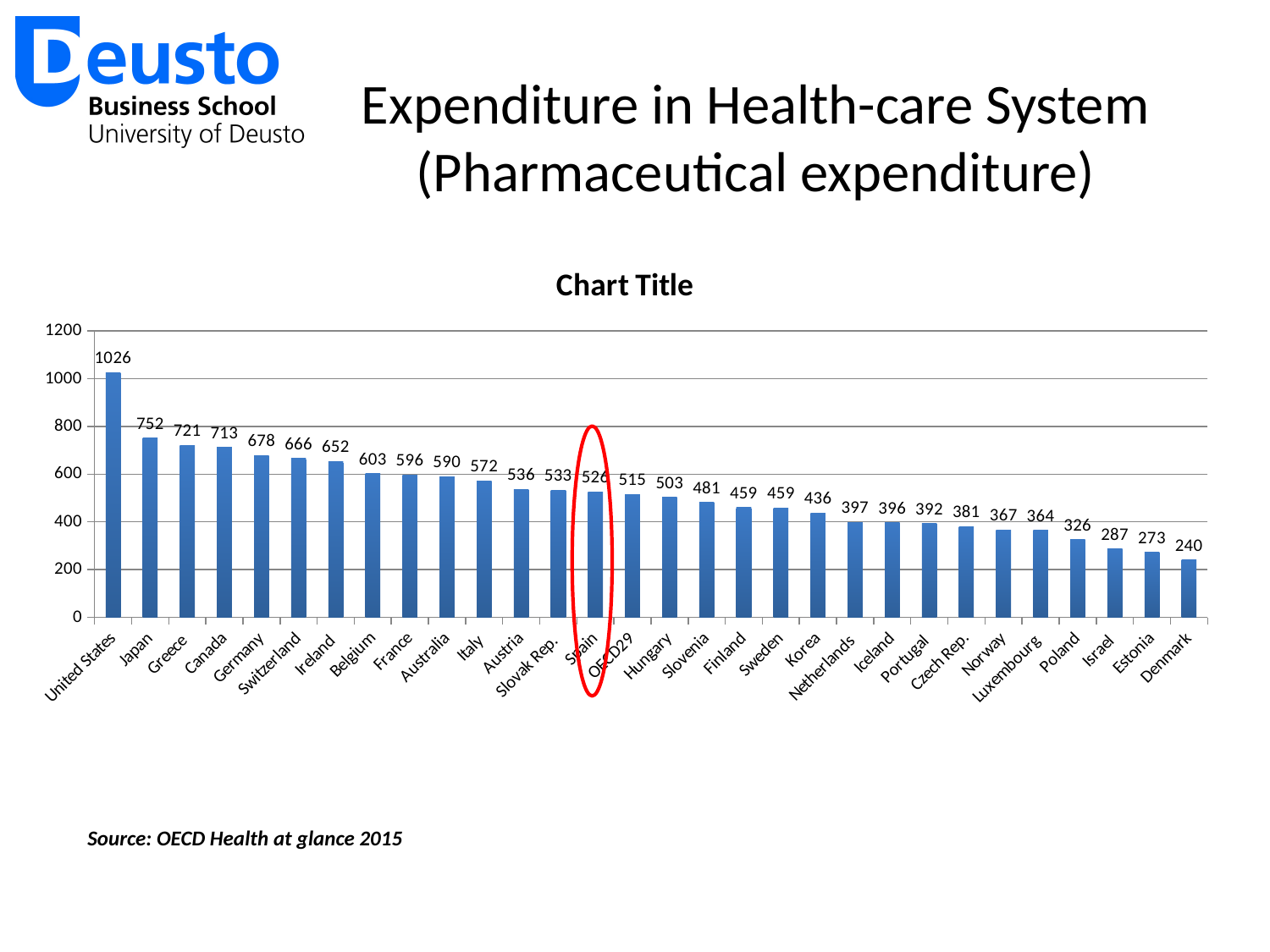
What is the value for Germany? 678 Which country has the lowest value? Denmark What is the value for the United States? 1026 Do the values rise or fall from left to right along the x axis? fall Is the value for Poland greater or less than 400? less Which has a larger value, Belgium or Hungary? Belgium What is the value for Korea? 436 What is the difference between the values for Spain and Denmark? 286 How many bars are shown in the chart? 30 What kind of chart is shown on the slide? bar chart Which country has the highest value? United States What is the difference between the values for Japan and Greece? 31